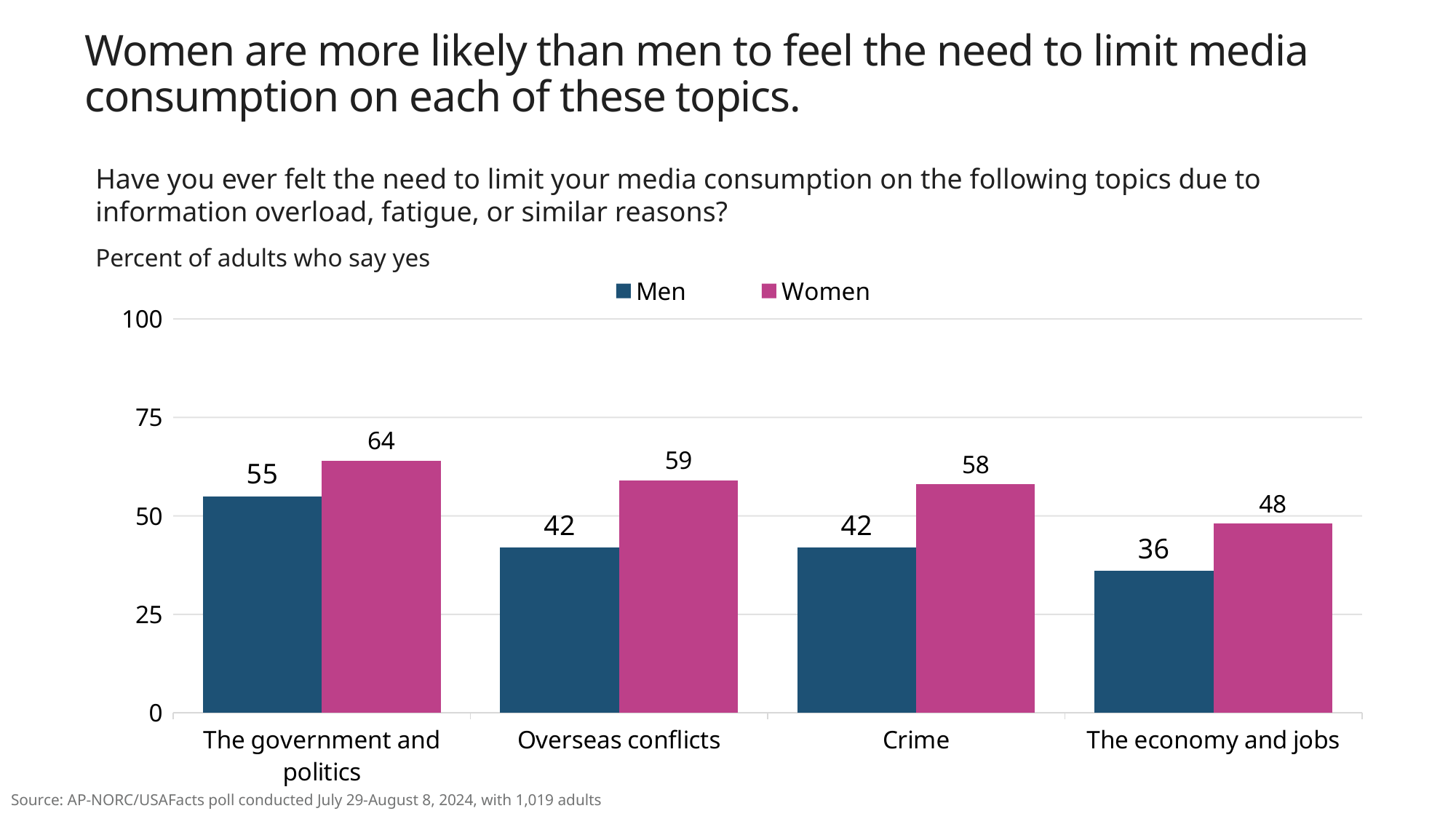
How many series does the legend list? 2 What kind of chart is shown on the slide? Bar chart What percent of men say they have felt the need to limit media consumption on the government and politics? 55 Which colour represents Women in the chart? Pink (magenta) Which is larger: the men's value for Crime or the women's value for The economy and jobs? Women's value for The economy and jobs What percent of women say they have felt the need to limit media consumption on the economy and jobs? 48 Which topic has the lowest value for men? The economy and jobs What is the difference between the women's and men's values for Overseas conflicts? 17 How many topics are shown on the x axis? 4 What is the difference between the men's values for The government and politics and The economy and jobs? 19 What is the value for women for Crime? 58 Which topic has the highest value for women? The government and politics